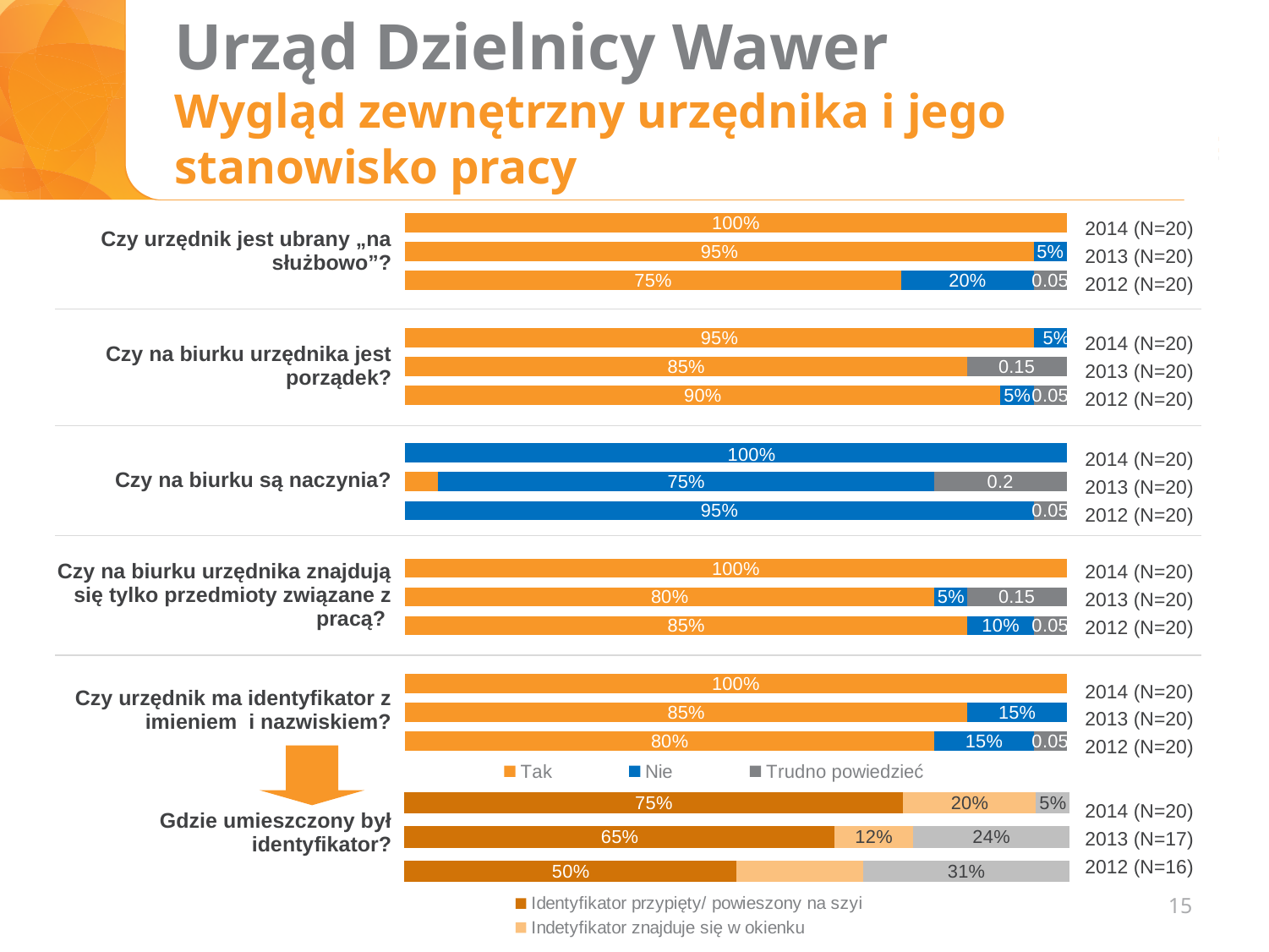
In the chart for "Czy na biurku urzędnika jest porządek?", what is the "Tak" value for 2013 (N=20)? 85% What type of chart is used for "Czy urzędnik jest ubrany „na służbowo”?"? Stacked bar chart In the chart for "Czy urzędnik jest ubrany „na służbowo”?", what is the "Nie" value for 2012 (N=20)? 20% In the chart for "Czy na biurku urzędnika jest porządek?", which year has the highest "Tak" value? 2014 (N=20) In the chart for "Czy urzędnik ma identyfikator z imieniem i nazwiskiem?", what is the difference between the "Tak" values for 2014 and 2012? 20% In the chart for "Czy urzędnik jest ubrany „na służbowo”?", what is the "Tak" value for 2014 (N=20)? 100% In the chart for "Czy na biurku urzędnika znajdują się tylko przedmioty związane z pracą?", what is the "Tak" value for 2012 (N=20)? 85% In the chart for "Czy urzędnik ma identyfikator z imieniem i nazwiskiem?", is the "Tak" value larger for 2013 or 2012? 2013 In the chart for "Czy na biurku są naczynia?", what is the "Trudno powiedzieć" value for 2013 (N=20)? 0.2 In the chart for "Czy na biurku są naczynia?", what is the "Nie" value for 2013 (N=20)? 75% In the chart for "Gdzie umieszczony był identyfikator?", what is the value for "Identyfikator przypięty/ powieszony na szyi" in 2013 (N=17)? 65% In the chart for "Gdzie umieszczony był identyfikator?", what is the sample size for 2012? N=16